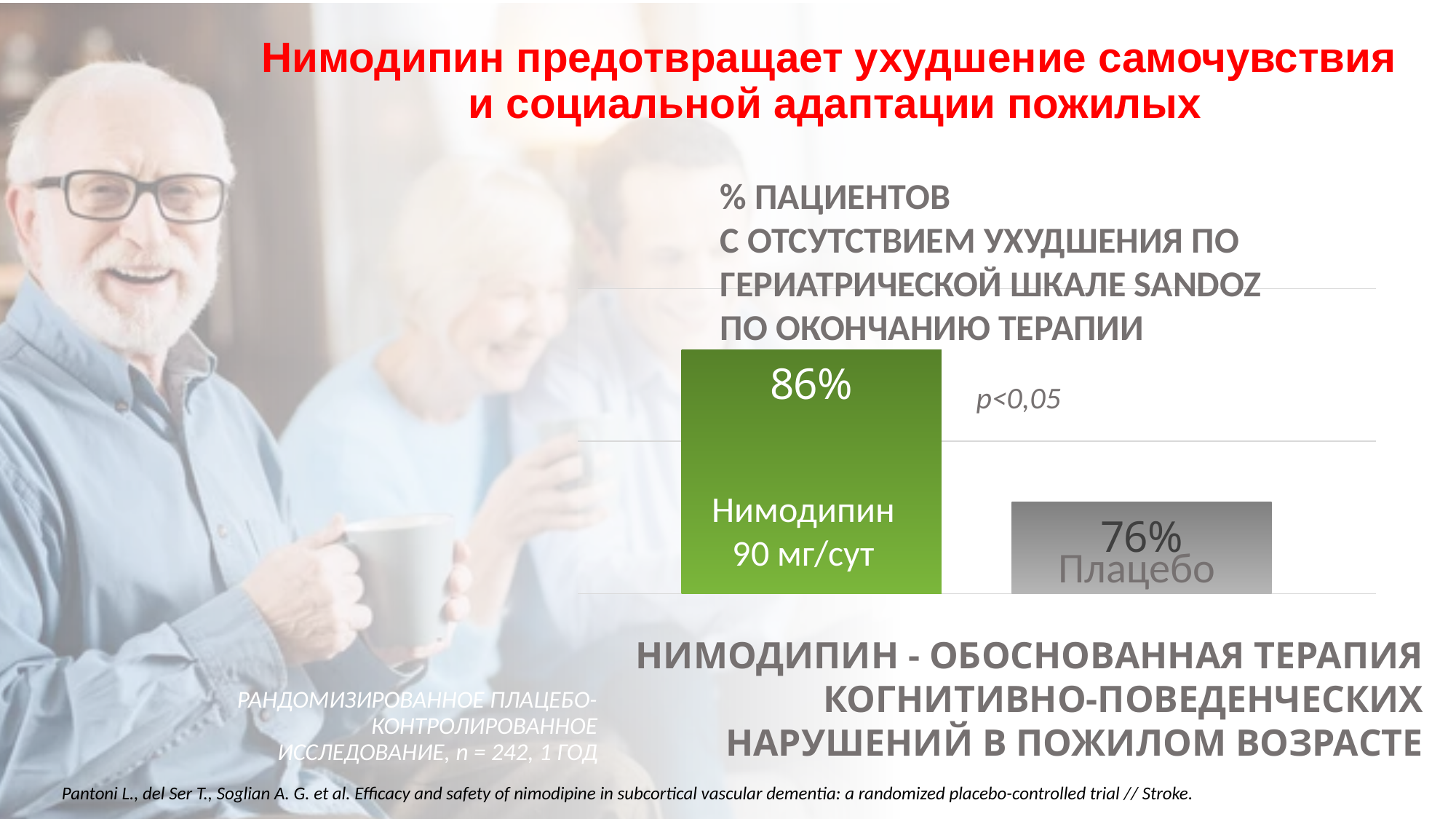
Which group has the higher percentage of patients with no deterioration? Нимодипин 90 мг/сут What p-value is shown next to the chart? p<0,05 How many bars (groups) are shown in the chart? 2 What colour is the bar for Нимодипин 90 мг/сут? green What is the difference in percentage points between the Нимодипин 90 мг/сут bar and the Плацебо bar? 10 What percentage of patients showed no deterioration on the Sandoz geriatric scale in the Нимодипин 90 мг/сут group? 86% Which group has the lower percentage of patients with no deterioration? Плацебо What type of chart is shown on the slide? bar chart What percentage of patients showed no deterioration on the Sandoz geriatric scale in the Плацебо group? 76% Is the value for Нимодипин 90 мг/сут larger or smaller than the value for Плацебо? larger